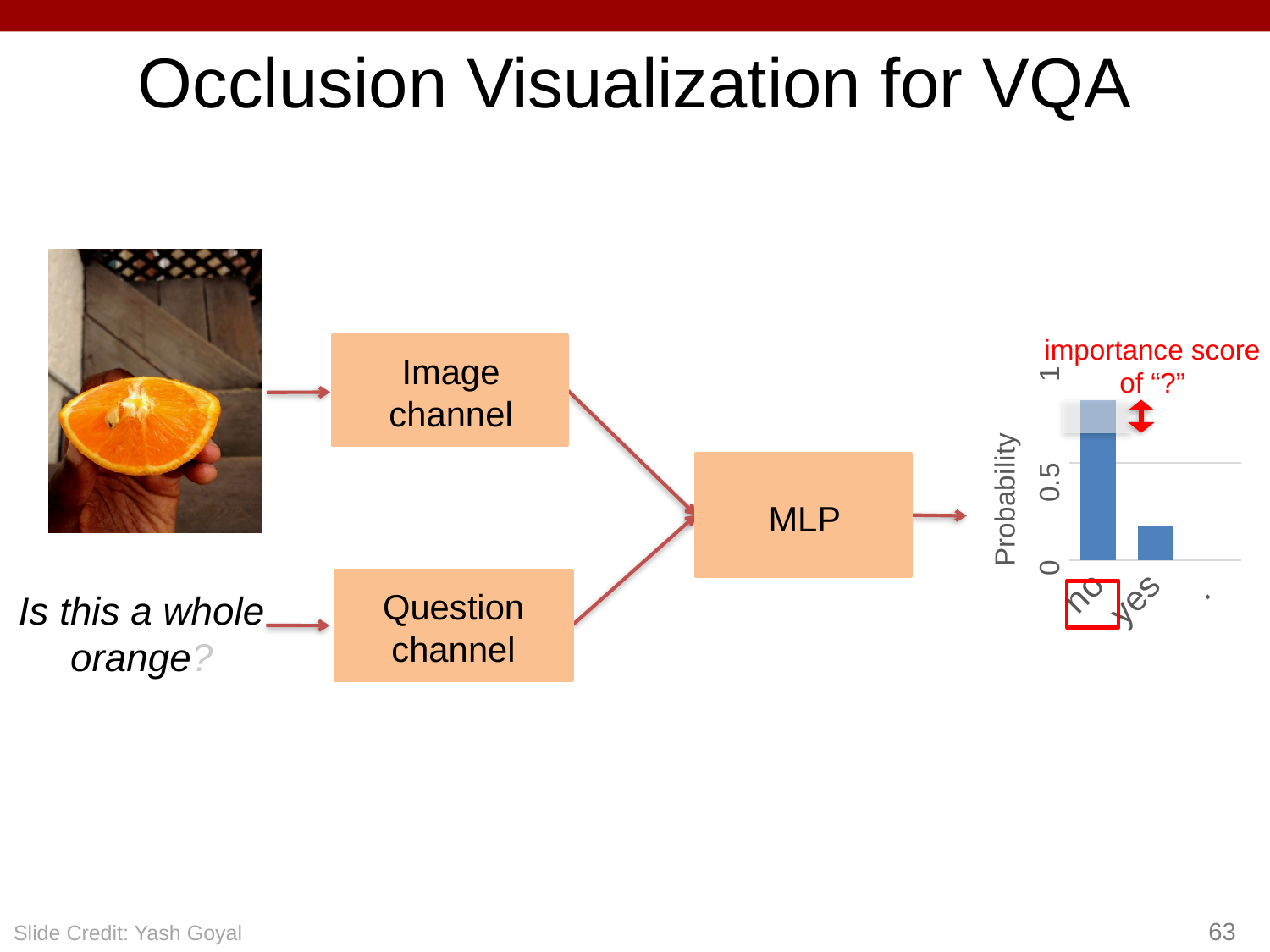
Is the probability for "yes" greater or less than 0.5? less How many bars are plotted in the chart? 2 What kind of chart is shown on the right of the slide? bar chart Which category has the highest probability in the bar chart? no Do the bar values rise or fall going from "no" to "yes" along the x axis? fall Which bar is taller, "no" or "yes"? no What is the label on the vertical axis of the bar chart? Probability What is the highest tick value shown on the vertical axis of the bar chart? 1 Is the probability for "no" greater or less than 0.5? greater Which category has the lowest probability in the bar chart? yes